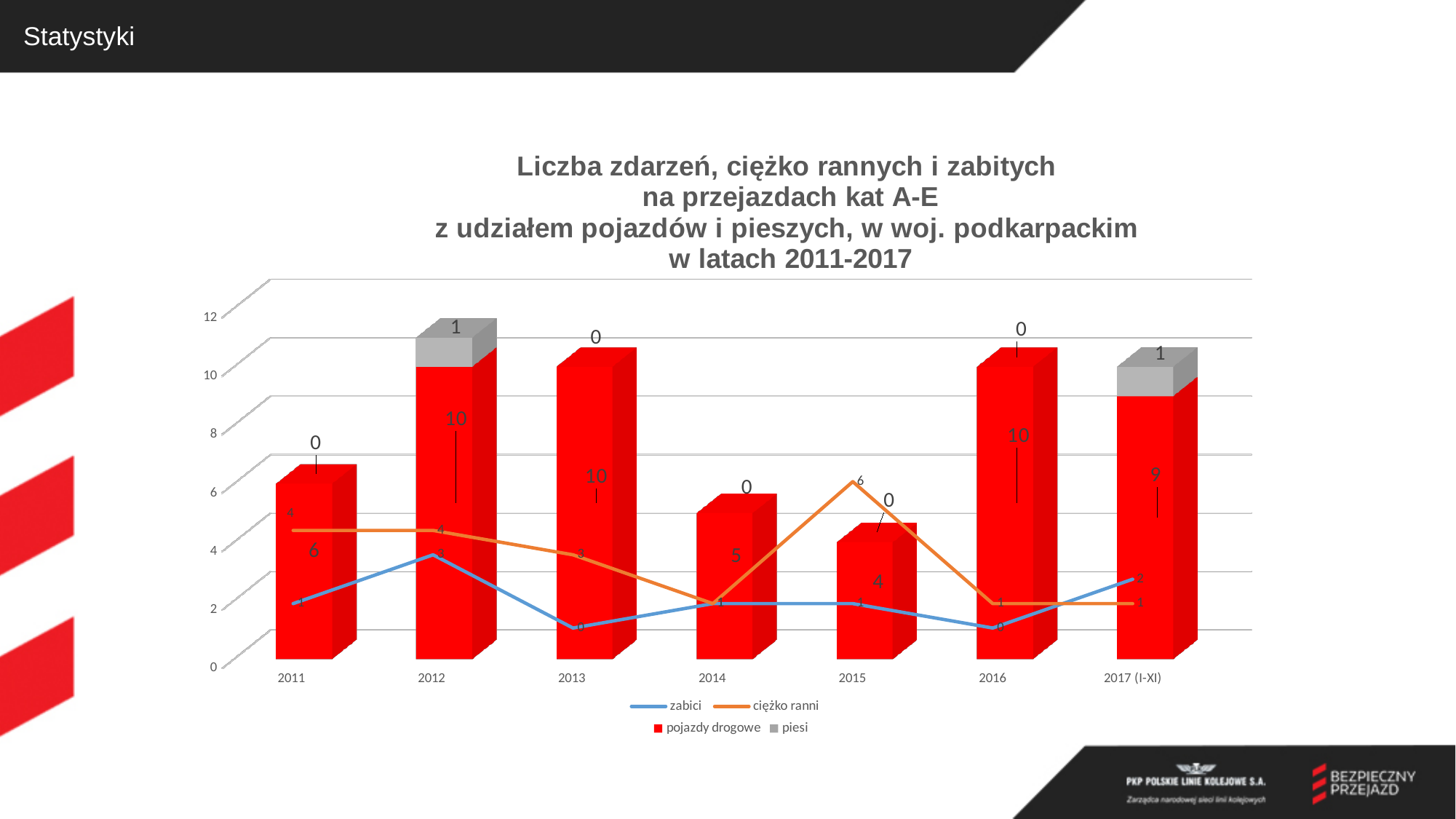
Which year has the highest value for ciężko ranni? 2015 What is the value for ciężko ranni in 2015? 6 How many series does the legend list? 4 Which series is drawn as an orange line? ciężko ranni What is the difference between the pojazdy drogowe values for 2012 and 2014? 5 Which is larger, the ciężko ranni value for 2011 or for 2014? 2011 What is the value for zabici in 2012? 3 What is the total of the stacked bar for 2017 (I-XI)? 10 What is the value for piesi in 2012? 1 How many years are shown on the x axis? 7 What is the value for pojazdy drogowe in 2013? 10 Which year has the lowest value for pojazdy drogowe? 2015